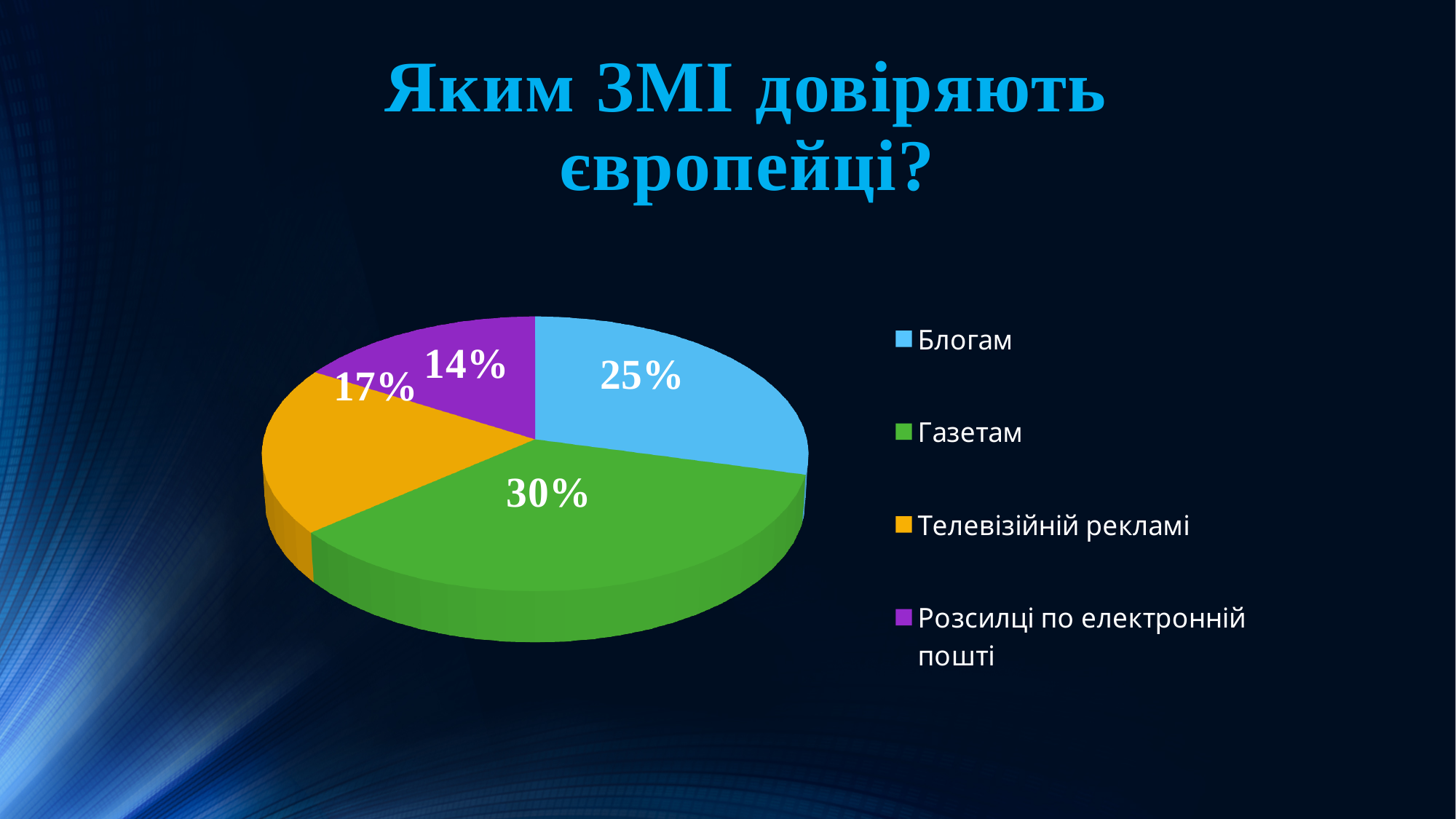
What share of the pie is labelled for Розсилці по електронній пошті? 14% What share of the pie is labelled for Телевізійній рекламі? 17% What share of the pie is labelled for Блогам? 25% Which category has the largest slice of the pie? Газетам How many slices does the pie chart have? 4 What colour is the slice for Газетам? Green What is the difference between the shares for Газетам and Блогам? 5% Which category has the smallest slice of the pie? Розсилці по електронній пошті What kind of chart is shown on the slide? Pie chart What share of the pie is labelled for Газетам? 30% What is the difference between the shares for Телевізійній рекламі and Розсилці по електронній пошті? 3% Which is larger, the share for Блогам or the share for Телевізійній рекламі? Блогам